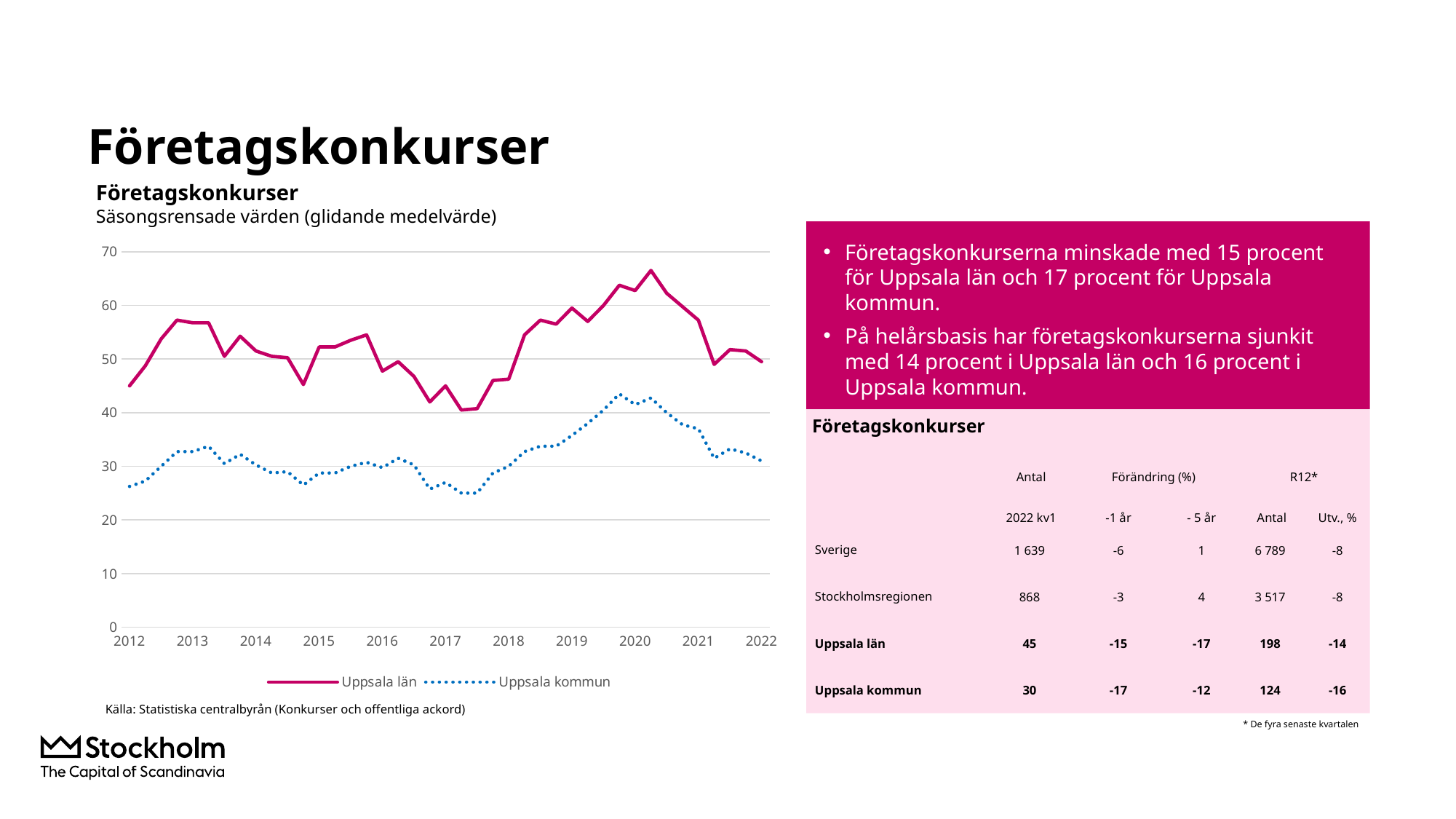
Which series has the higher value in 2020, Uppsala län or Uppsala kommun? Uppsala län How many series does the chart legend list? 2 Is the peak value for Uppsala kommun around 2020 greater or less than 40? greater Is the peak value for Uppsala län around 2020 greater or less than 60? greater What kind of chart is shown on the slide? line chart How many year labels are shown on the x axis of the chart? 11 What is the subtitle shown under the chart title 'Företagskonkurser'? Säsongsrensade värden (glidande medelvärde) Is the value for Uppsala län at the start of 2012 greater or less than 50? less Does the Uppsala län line rise or fall between 2017 and 2020? rise What are the two series named in the chart legend? Uppsala län and Uppsala kommun